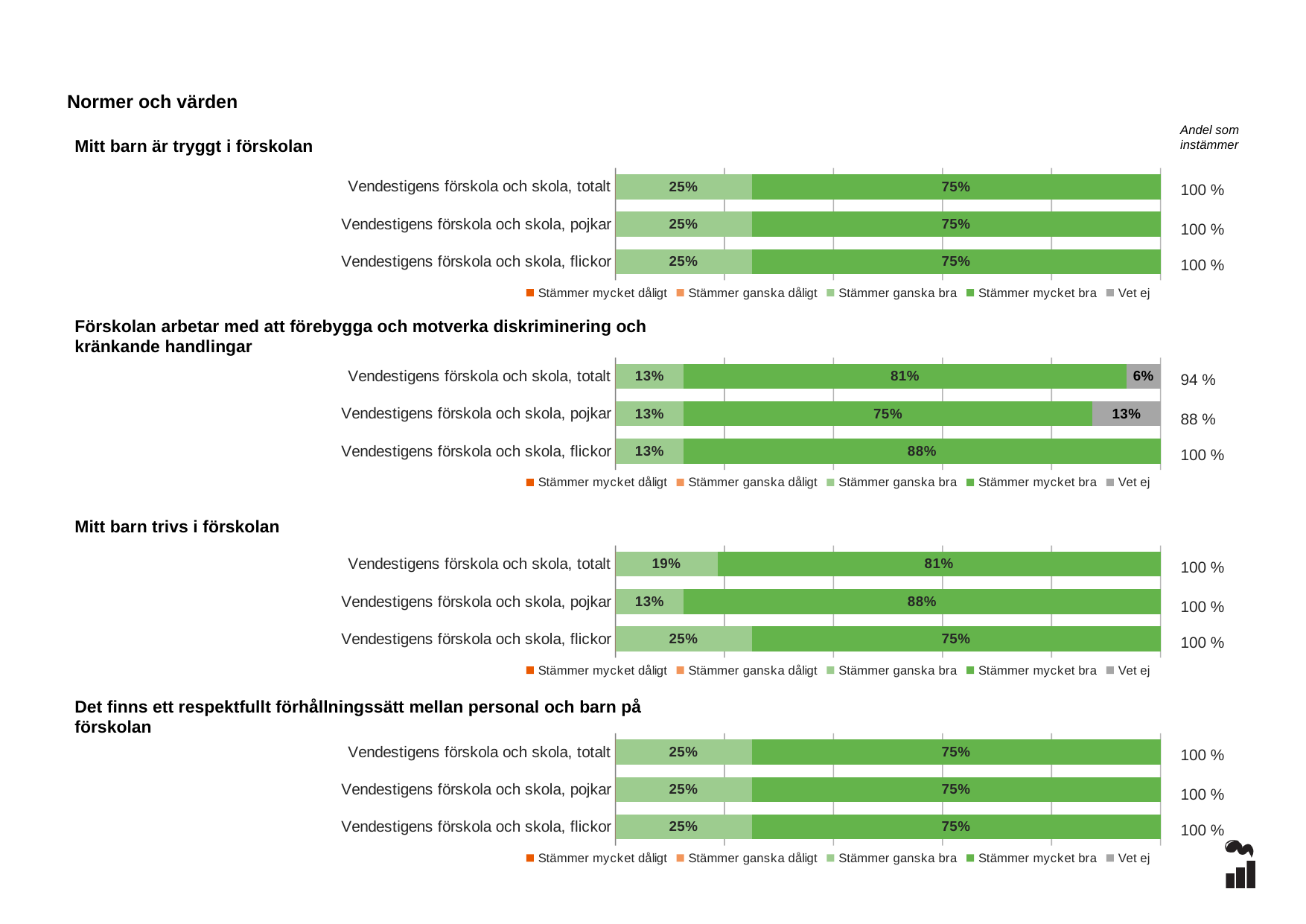
In the chart 'Förskolan arbetar med att förebygga och motverka diskriminering och kränkande handlingar', which category has the highest 'Stämmer mycket bra' value? Vendestigens förskola och skola, flickor What kind of chart is 'Mitt barn trivs i förskolan'? Stacked bar chart In the chart 'Mitt barn trivs i förskolan', which category has the lowest 'Stämmer ganska bra' value? Vendestigens förskola och skola, pojkar In the chart 'Mitt barn trivs i förskolan', which is larger: the 'Stämmer mycket bra' value for 'pojkar' or for 'flickor'? Vendestigens förskola och skola, pojkar In the chart 'Förskolan arbetar med att förebygga och motverka diskriminering och kränkande handlingar', what is the difference between the 'Stämmer mycket bra' values for 'flickor' and 'pojkar'? 13% In the chart 'Mitt barn trivs i förskolan', what is the 'Stämmer ganska bra' value for 'Vendestigens förskola och skola, totalt'? 19% In the chart 'Förskolan arbetar med att förebygga och motverka diskriminering och kränkande handlingar', what is the 'Vet ej' value for 'Vendestigens förskola och skola, pojkar'? 13% In the chart 'Förskolan arbetar med att förebygga och motverka diskriminering och kränkande handlingar', what is the 'Andel som instämmer' value shown for 'Vendestigens förskola och skola, pojkar'? 88 % How many series does the legend of the chart 'Mitt barn är tryggt i förskolan' list? 5 How many categories does the chart 'Det finns ett respektfullt förhållningssätt mellan personal och barn på förskolan' show? 3 In the chart 'Mitt barn är tryggt i förskolan', what is the 'Stämmer mycket bra' value for 'Vendestigens förskola och skola, totalt'? 75% In the chart 'Förskolan arbetar med att förebygga och motverka diskriminering och kränkande handlingar', what is the 'Stämmer mycket bra' value for 'Vendestigens förskola och skola, flickor'? 88%